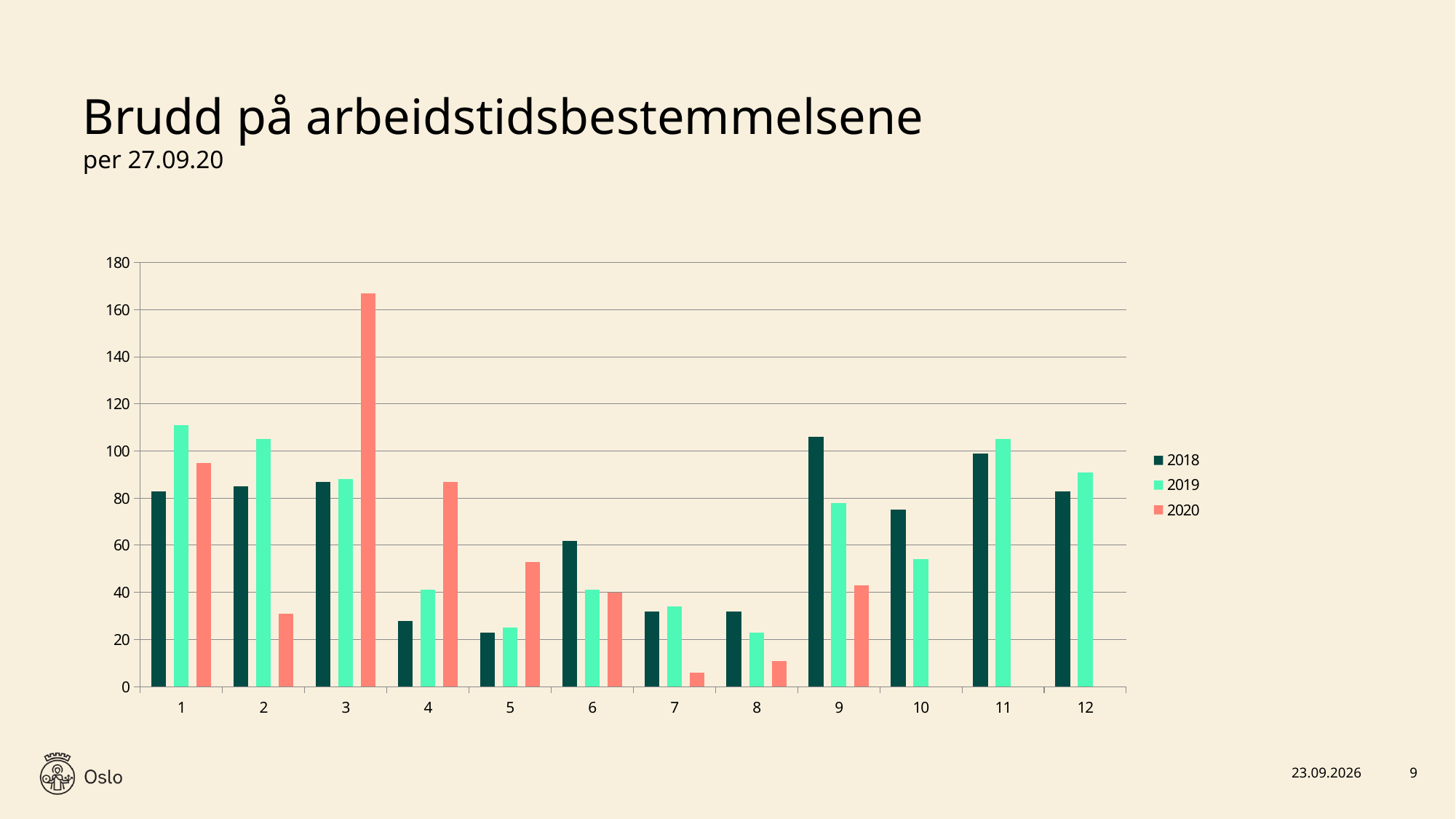
In category 10, which series has the larger value, 2018 or 2019? 2018 Which category has the highest value for the 2020 series? 3 What kind of chart is shown on the slide? bar chart Which category has the highest value for the 2018 series? 9 Is the value for 2018 in category 9 greater or less than 100? greater How many series does the legend list? 3 Is the value for 2019 in category 5 greater or less than 40? less How many categories are shown along the x axis? 12 What are the entries listed in the chart legend? 2018, 2019, 2020 Which category has the lowest value for the 2020 series? 7 In category 1, which series has the larger value, 2018 or 2019? 2019 Is the value for 2020 in category 3 greater or less than 160? greater